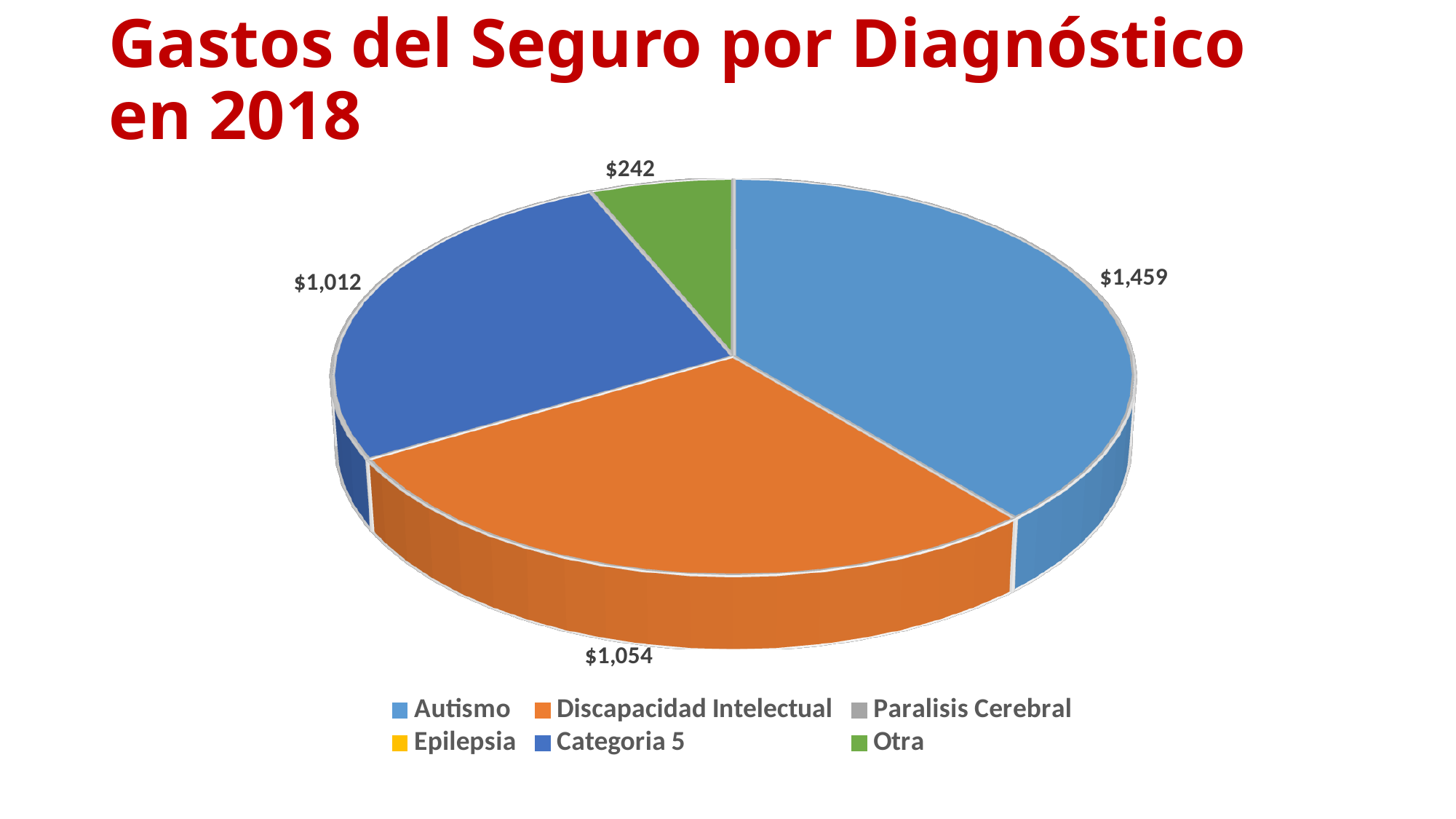
How many entries does the legend list? 6 What kind of chart is shown on the slide? Pie chart What is the difference between the values for Autismo and Discapacidad Intelectual? $405 What is the value shown for Categoria 5? $1,012 What is the difference between the values for Discapacidad Intelectual and Categoria 5? $42 What is the title of the chart? Gastos del Seguro por Diagnóstico en 2018 What is the value shown for Discapacidad Intelectual? $1,054 Which is larger, the value for Categoria 5 or the value for Otra? Categoria 5 What is the value shown for Autismo? $1,459 Which category has the largest slice of the pie? Autismo What is the value shown for Otra? $242 Which labeled slice has the smallest value? Otra